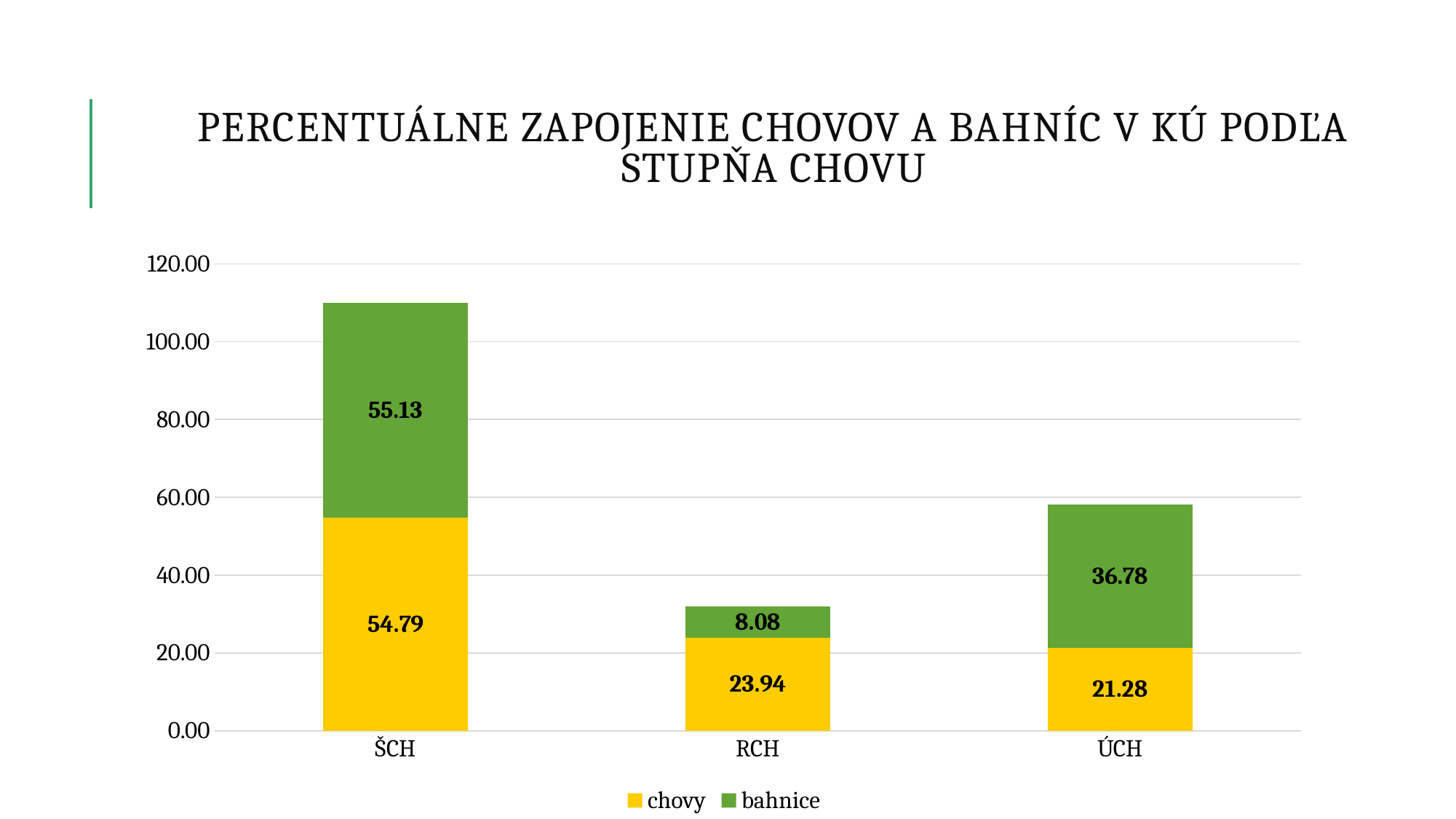
What is the value for bahnice in the ÚCH category? 36.78 Which is larger in the ÚCH category, chovy or bahnice? bahnice What is the value for chovy in the ŠCH category? 54.79 How many series does the legend list? 2 What kind of chart is shown on the slide? stacked bar chart Is the total height of the ŠCH stacked bar greater or less than 100.00? greater What is the value for bahnice in the RCH category? 8.08 Which category has the lowest value for bahnice? RCH Which category has the highest value for chovy? ŠCH What is the difference between the chovy and bahnice values in the RCH category? 15.86 How many categories are shown on the x axis? 3 What is the total of the stacked bar for ÚCH? 58.06